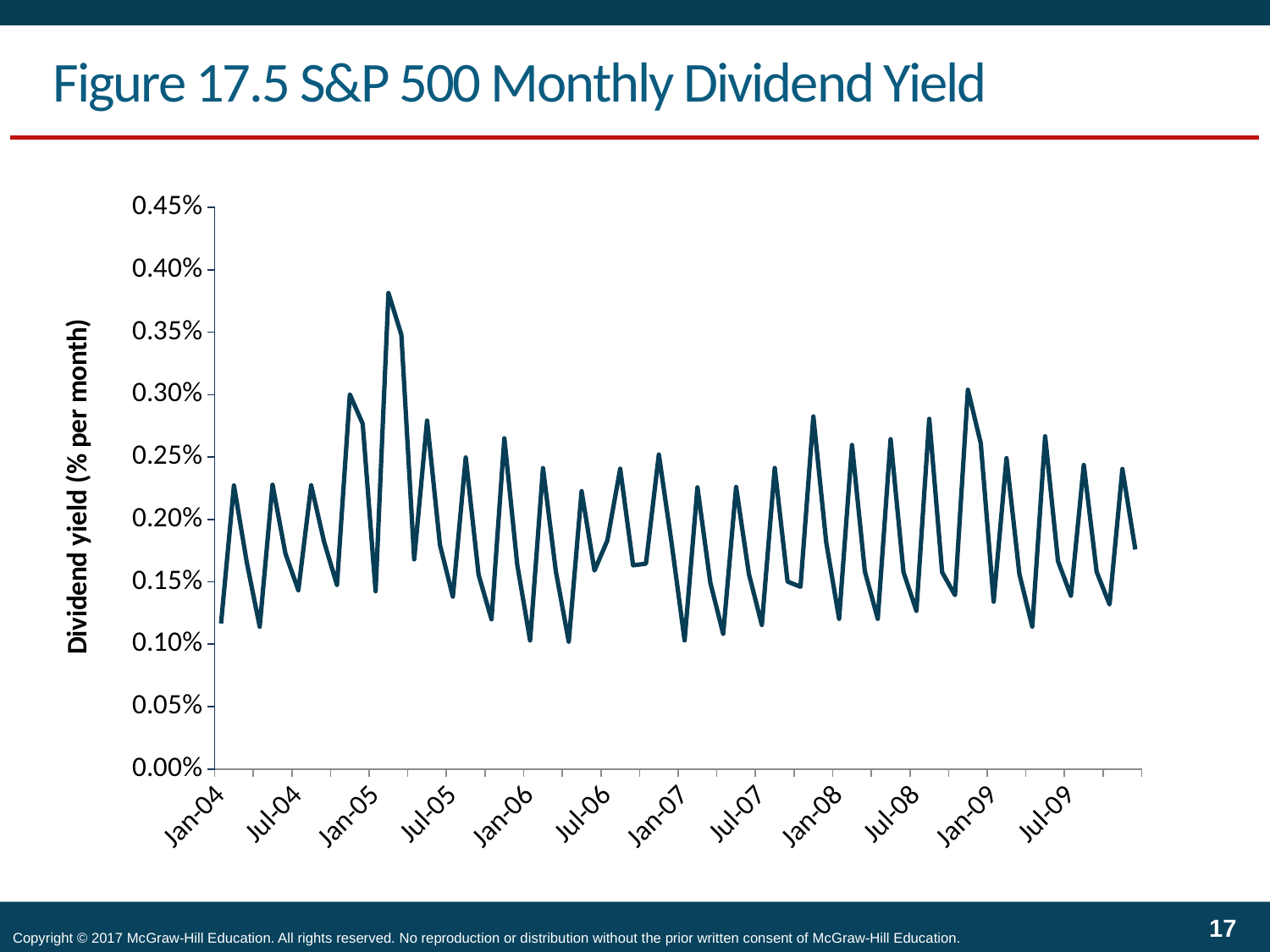
What kind of chart is shown on the slide? line chart Is the lowest point on the dividend yield line greater or less than 0.15%? less Does the dividend yield line ever fall below 0.05%? No What is the highest tick value shown on the vertical axis? 0.45% Is the highest peak of the dividend yield line greater or less than 0.35%? greater In which year does the dividend yield line reach its highest peak? 2005 What is the title of the chart on the slide? Figure 17.5 S&P 500 Monthly Dividend Yield How many date labels are printed along the horizontal axis? 12 What is the first date label on the horizontal axis? Jan-04 What is the label on the vertical axis of the chart? Dividend yield (% per month)